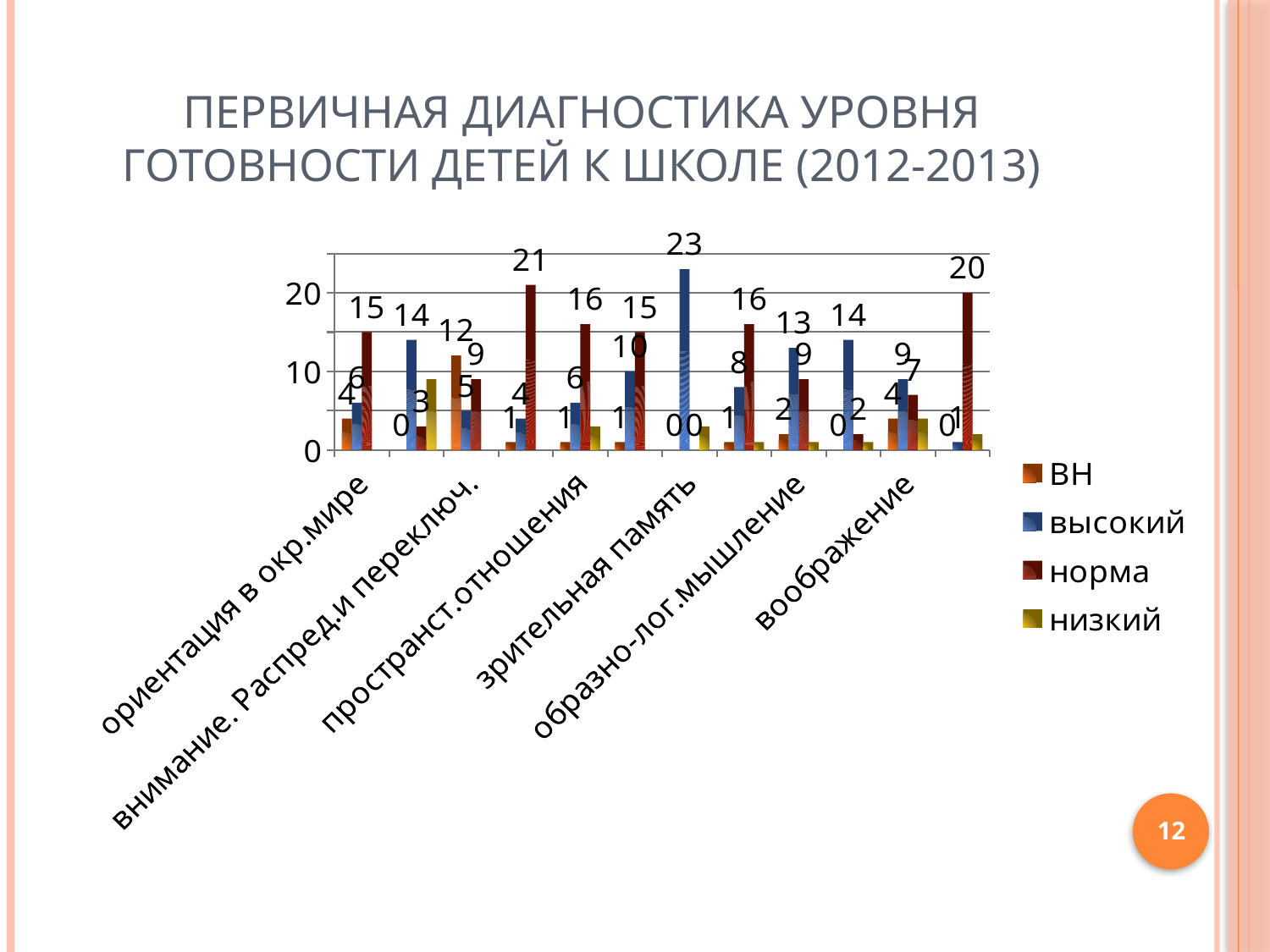
Which series has the highest value for 'зрительная память'? высокий What is the value of the 'высокий' series for 'зрительная память'? 23 Is the 'норма' value for 'ориентация в окр.мире' greater or less than 10? greater What kind of chart is shown on the slide? bar chart What are the series names listed in the legend? ВН, высокий, норма, низкий How many series does the legend list? 4 What is the value of the 'высокий' series for 'образно-лог.мышление'? 13 Which is larger for 'образно-лог.мышление': the 'высокий' value or the 'норма' value? высокий What is the value of the 'ВН' series for 'воображение'? 4 What is the value of the 'норма' series for 'ориентация в окр.мире'? 15 What is the value of the 'норма' series for 'образно-лог.мышление'? 9 What is the difference between the 'высокий' and 'норма' values for 'образно-лог.мышление'? 4